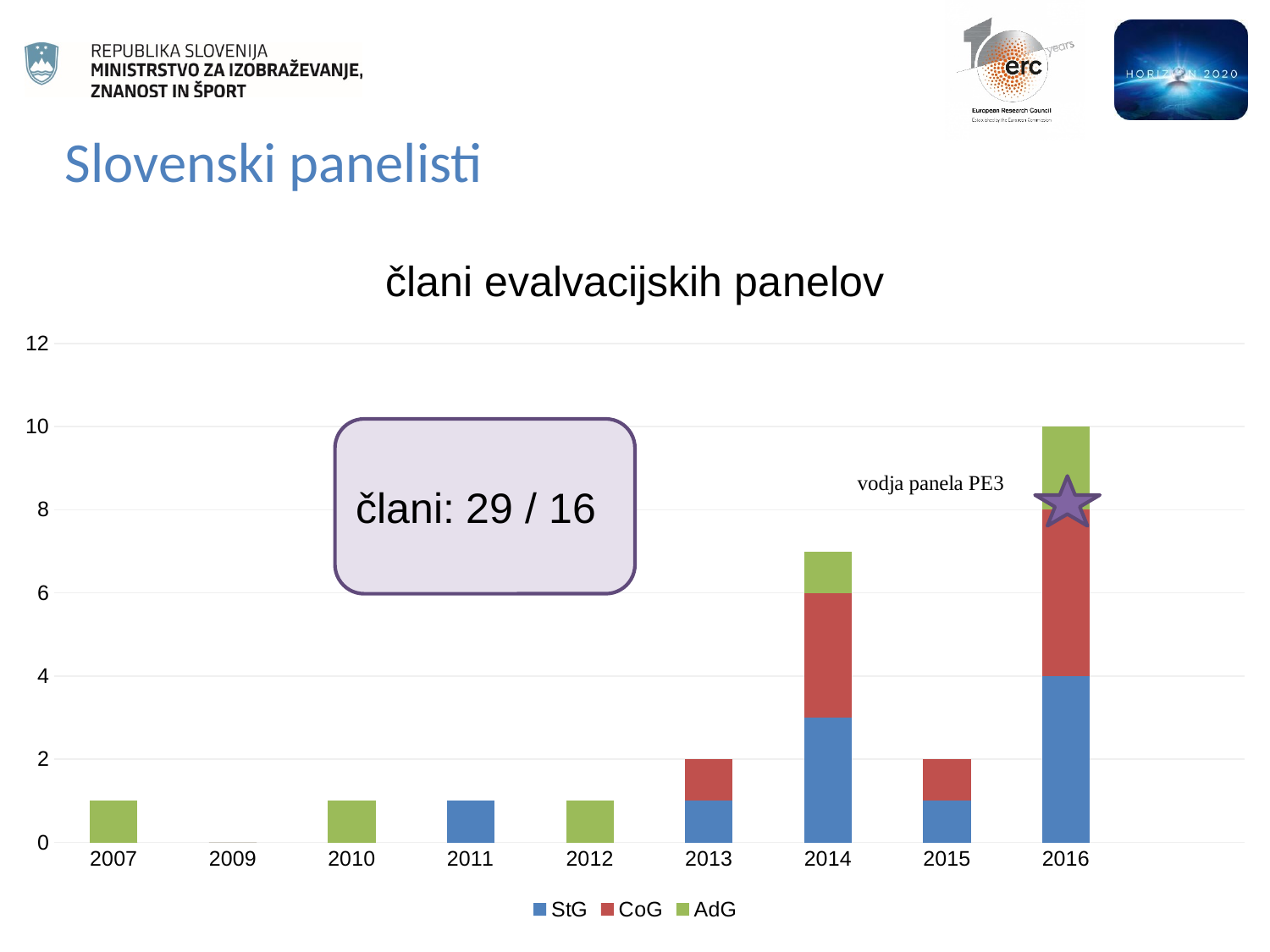
What is the title of the chart? člani evalvacijskih panelov How many series does the legend list? 3 How many years are shown on the x axis? 9 Which series are listed in the legend? StG, CoG, AdG Which year has a larger total, 2014 or 2015? 2014 What kind of chart is shown on the slide? stacked bar chart What is the total height of the stacked bar for 2013? 2 What is the total height of the stacked bar for 2016? 10 Is the total for 2007 greater or less than 2? less Is the total for 2014 greater or less than 6? greater Which year has the tallest stacked bar? 2016 What is the StG value for 2016? 4